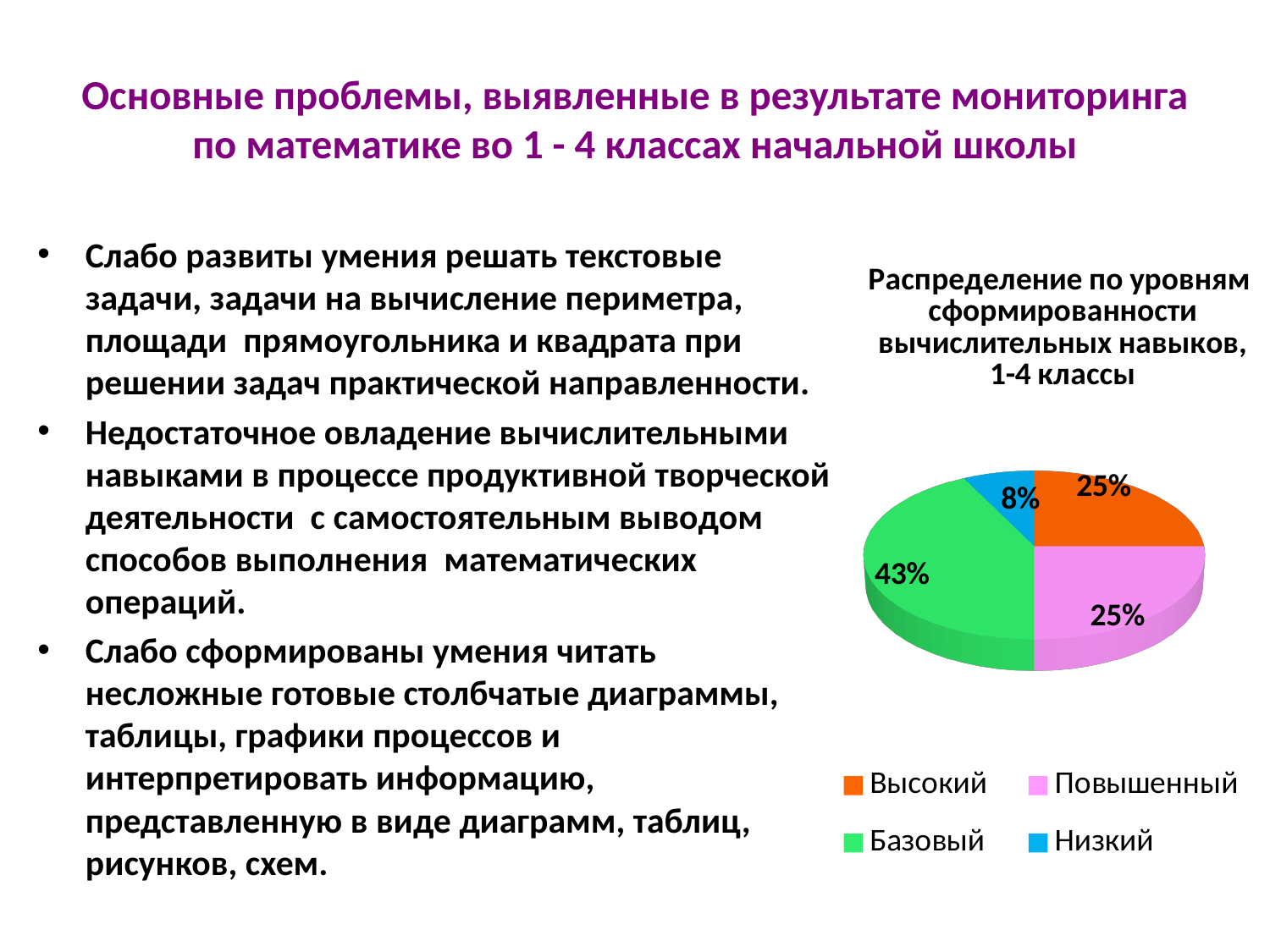
What colour is the Высокий slice in the pie chart? orange What is the value shown for the Повышенный level? 25% How many slices does the pie chart have? 4 What is the value shown for the Высокий level? 25% What is the difference between the Базовый and Низкий shares? 35% What kind of chart is shown on the slide? pie chart Which is larger, the Базовый share or the Высокий share? Базовый Which level has the largest slice of the pie? Базовый What is the value shown for the Низкий level? 8% What share of the pie does the Базовый level have? 43% What is the difference between the Высокий and Низкий shares? 17% Which level has the smallest slice of the pie? Низкий